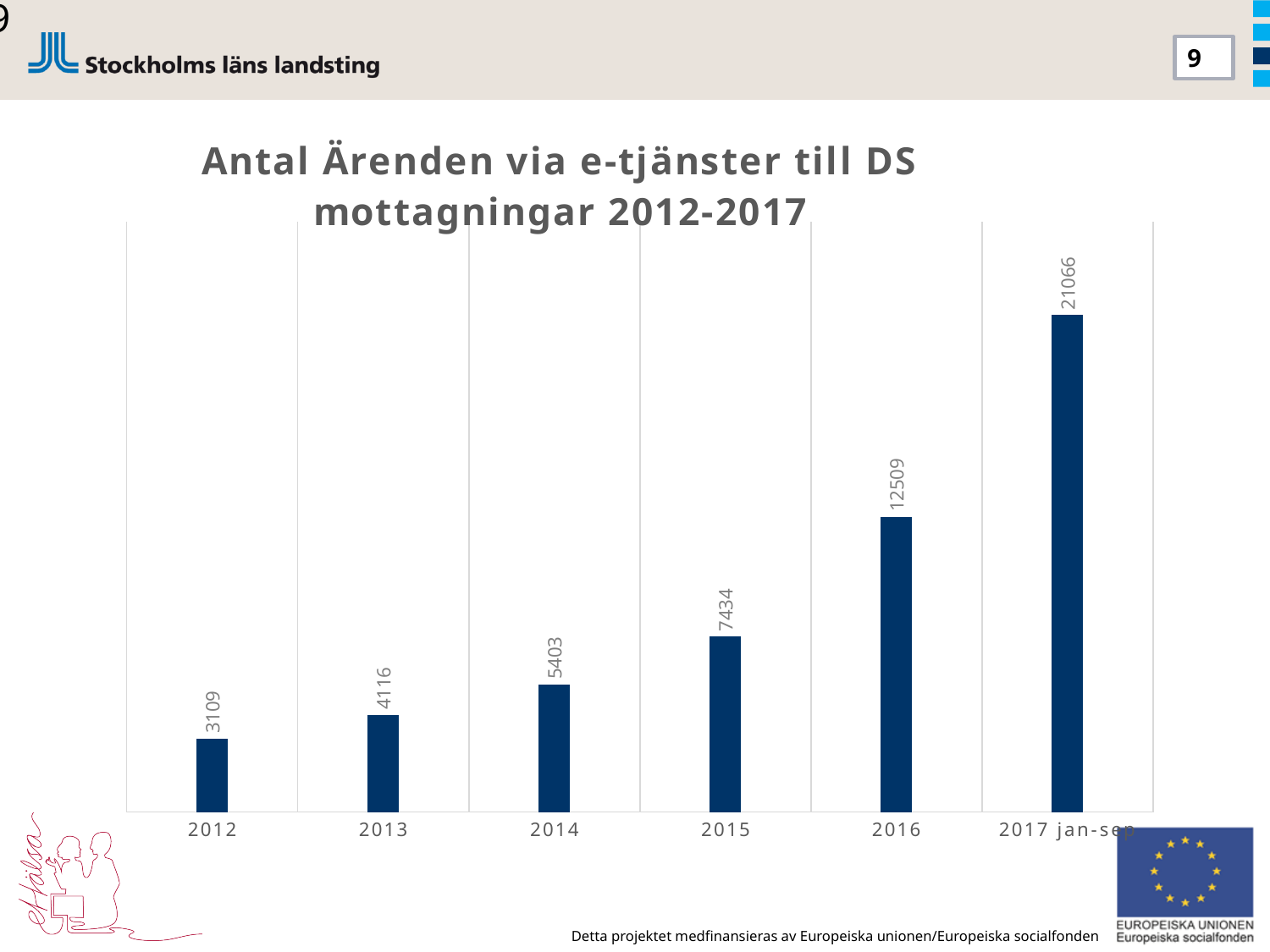
Do the values rise or fall from 2012 to 2017 jan-sep? rise What is the difference between the values for 2016 and 2015? 5075 What is the difference between the values for 2013 and 2012? 1007 What is the value for 2017 jan-sep? 21066 What is the title of the chart? Antal Ärenden via e-tjänster till DS mottagningar 2012-2017 What kind of chart is this? bar chart What is the value for 2015? 7434 Which is larger, the value for 2014 or the value for 2013? 2014 What is the value for 2012? 3109 Which category has the lowest value? 2012 Which category has the highest value? 2017 jan-sep How many categories are shown on the x axis? 6